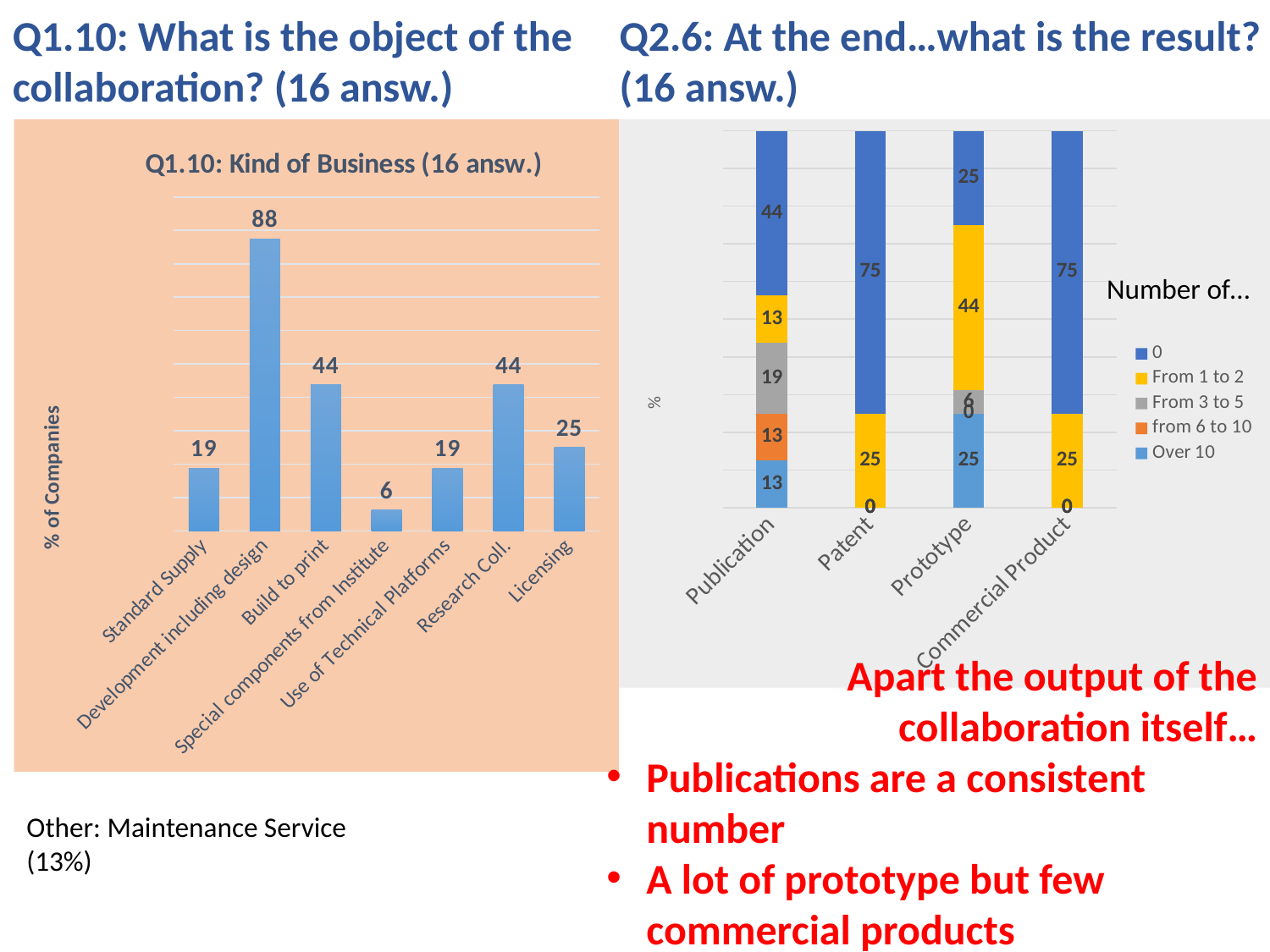
In the stacked bar chart on the right (Q2.6), what is the value of the "0" segment for Patent? 75 What kind of chart is the chart on the right (Q2.6)? Stacked bar chart In the stacked bar chart on the right (Q2.6), how many series does the legend list? 5 In the stacked bar chart on the right (Q2.6), what is the value of the "From 1 to 2" segment for Prototype? 44 In the chart titled "Q1.10: Kind of Business (16 answ.)", which category has the lowest value? Special components from Institute In the chart titled "Q1.10: Kind of Business (16 answ.)", what is the value for Development including design? 88 In the chart titled "Q1.10: Kind of Business (16 answ.)", what is the y-axis label? % of Companies In the chart titled "Q1.10: Kind of Business (16 answ.)", what is the difference between the values for Development including design and Build to print? 44 In the stacked bar chart on the right (Q2.6), what is the value of the "From 3 to 5" segment for Publication? 19 In the chart titled "Q1.10: Kind of Business (16 answ.)", what is the value for Licensing? 25 In the chart titled "Q1.10: Kind of Business (16 answ.)", how many categories are shown on the x axis? 7 In the chart titled "Q1.10: Kind of Business (16 answ.)", which category has the highest value? Development including design